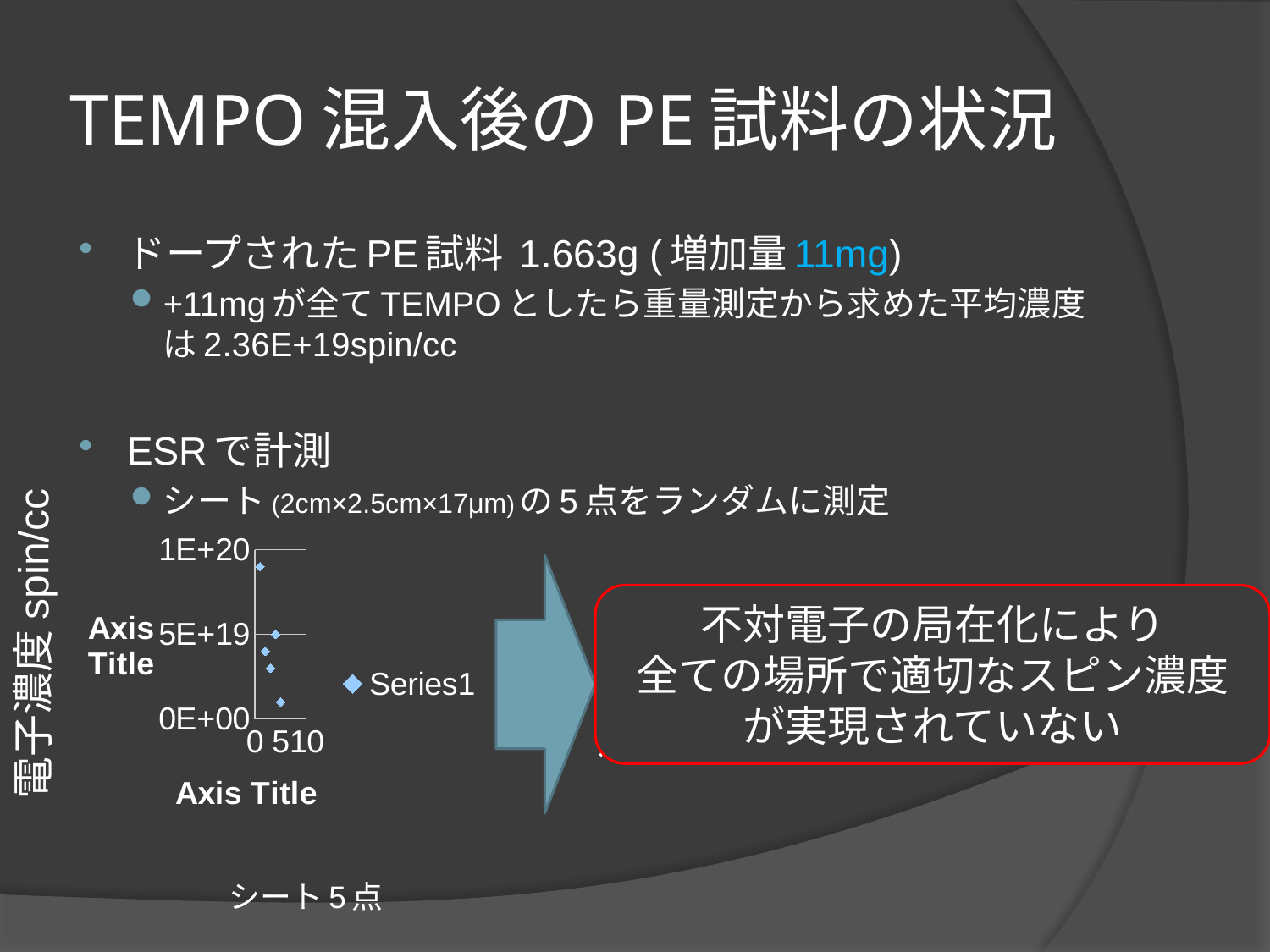
What is the name of the series shown in the chart legend? Series1 What kind of chart is shown on the slide? scatter chart What is the highest tick value shown on the chart's vertical axis? 1E+20 How many series does the chart legend list? 1 How many data points are plotted in the chart? 5 Is the value of the highest plotted point greater or less than 5E+19? greater Is the value of the lowest plotted point greater or less than 0E+00? greater Is the value of the lowest plotted point greater or less than 5E+19? less